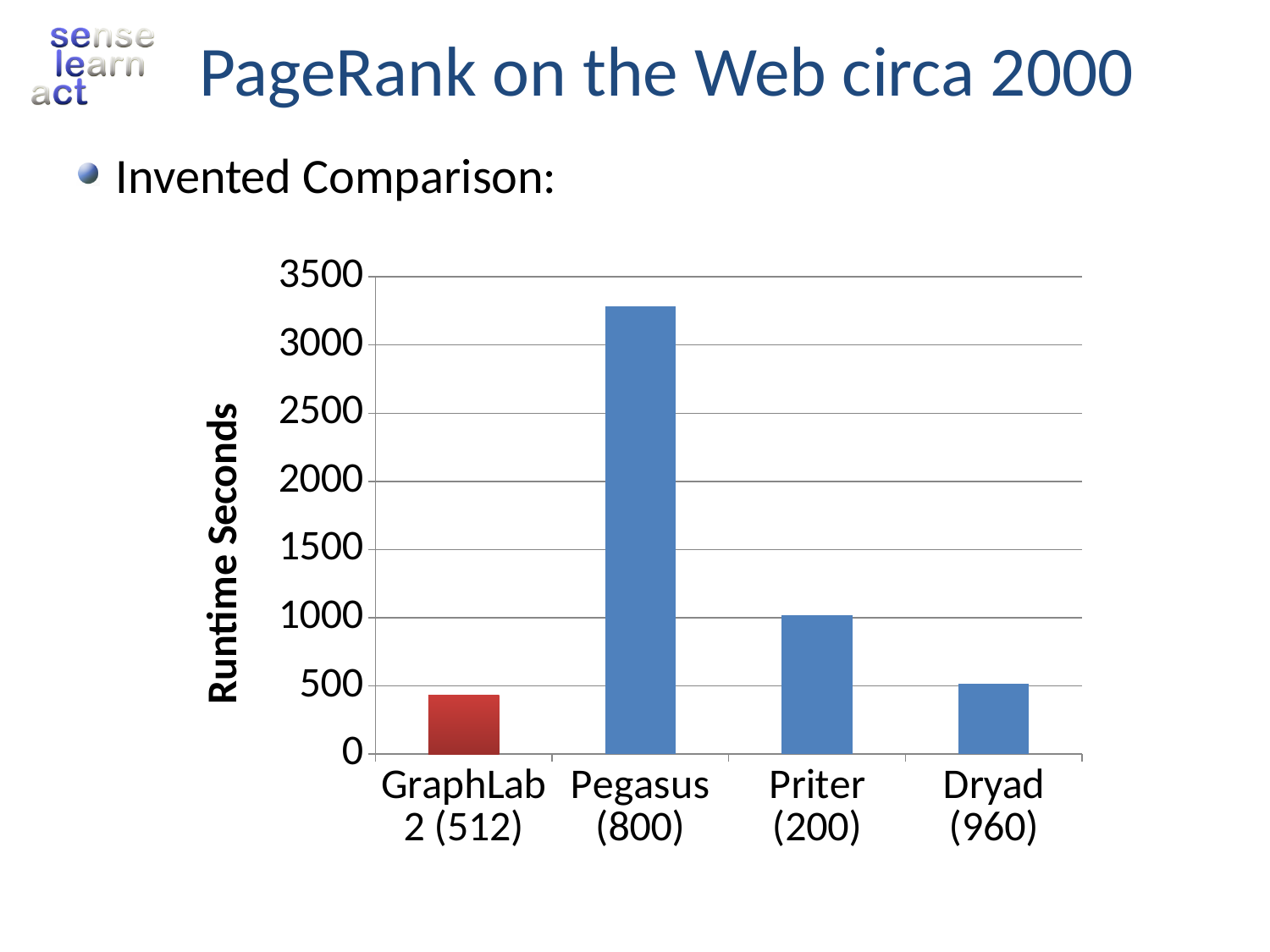
Is the runtime for Priter (200) greater or less than 1500? less What is the label on the vertical axis of the chart? Runtime Seconds Which has the larger runtime, Pegasus (800) or Priter (200)? Pegasus (800) Which has the larger runtime, Priter (200) or Dryad (960)? Priter (200) Is the runtime for GraphLab 2 (512) greater or less than 500? less Is the runtime for Dryad (960) greater or less than 1000? less Which category has the highest runtime in the chart? Pegasus (800) What kind of chart is shown on the slide? bar chart Which category has the lowest runtime in the chart? GraphLab 2 (512) How many categories are shown on the x axis of the chart? 4 Which category's bar is coloured red rather than blue? GraphLab 2 (512)